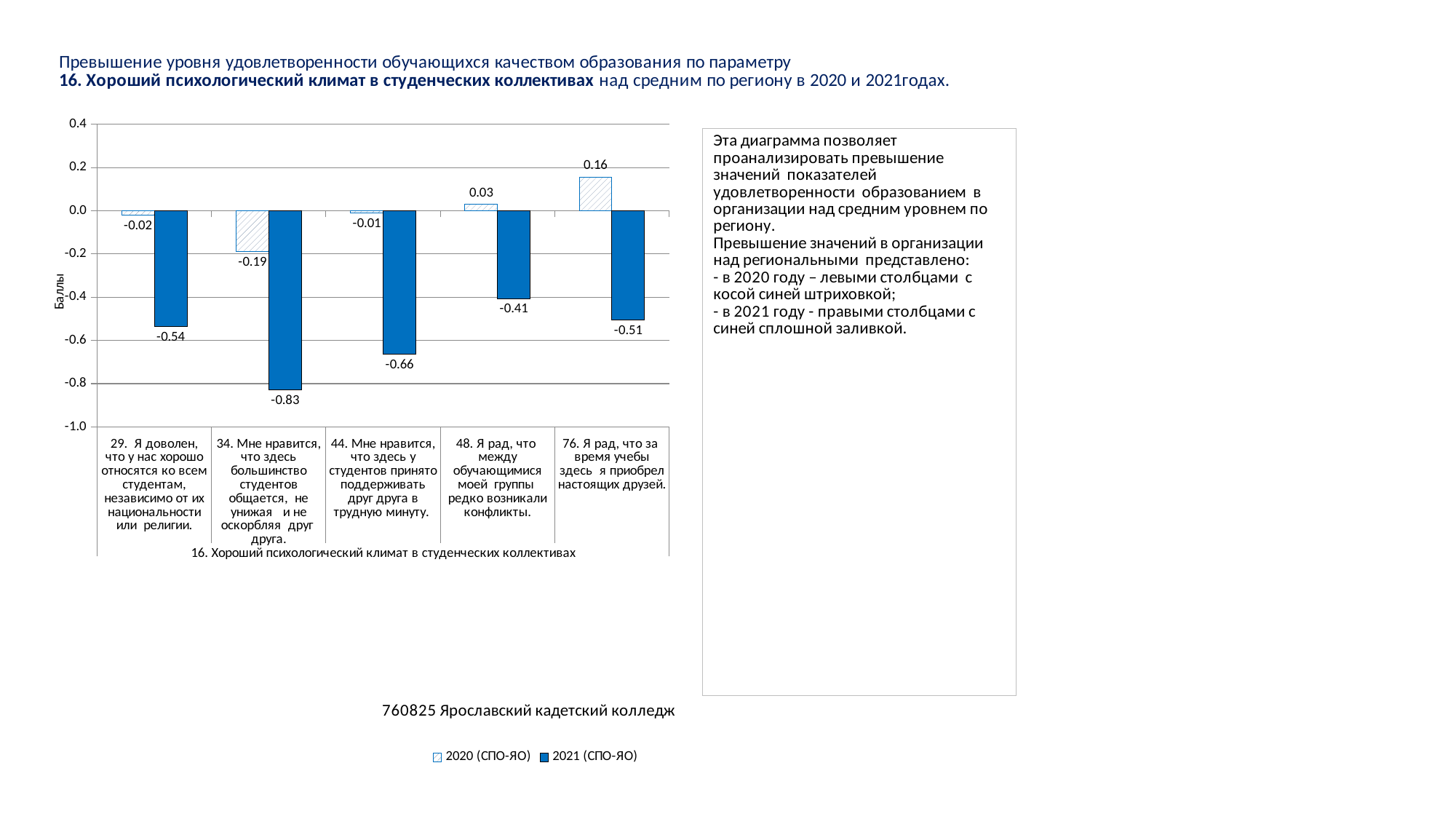
Which category has the highest 2020 (СПО-ЯО) value? 76. Я рад, что за время учебы здесь я приобрел настоящих друзей. What is the difference between the 2020 and 2021 values for category 29 ("Я доволен, что у нас хорошо относятся ко всем студентам...")? 0.52 What is the 2020 (СПО-ЯО) value for category 76 ("Я рад, что за время учебы здесь я приобрел настоящих друзей")? 0.16 How many categories (questions) are shown on the x axis of the chart? 5 What type of chart is shown on the slide? Bar chart What is the label of the vertical axis of the chart? Баллы Which category has the lowest 2021 (СПО-ЯО) value? 34. Мне нравится, что здесь большинство студентов общается, не унижая и не оскорбляя друг друга. Which is larger: the 2021 value for category 44 or the 2021 value for category 48? Category 48 (-0.41) What is the 2020 (СПО-ЯО) value for category 48 ("Я рад, что между обучающимися моей группы редко возникали конфликты")? 0.03 Which series is shown with hatched (striped) bars according to the legend? 2020 (СПО-ЯО) How many series does the legend list? 2 What is the 2021 (СПО-ЯО) value for category 34 ("Мне нравится, что здесь большинство студентов общается, не унижая и не оскорбляя друг друга")? -0.83